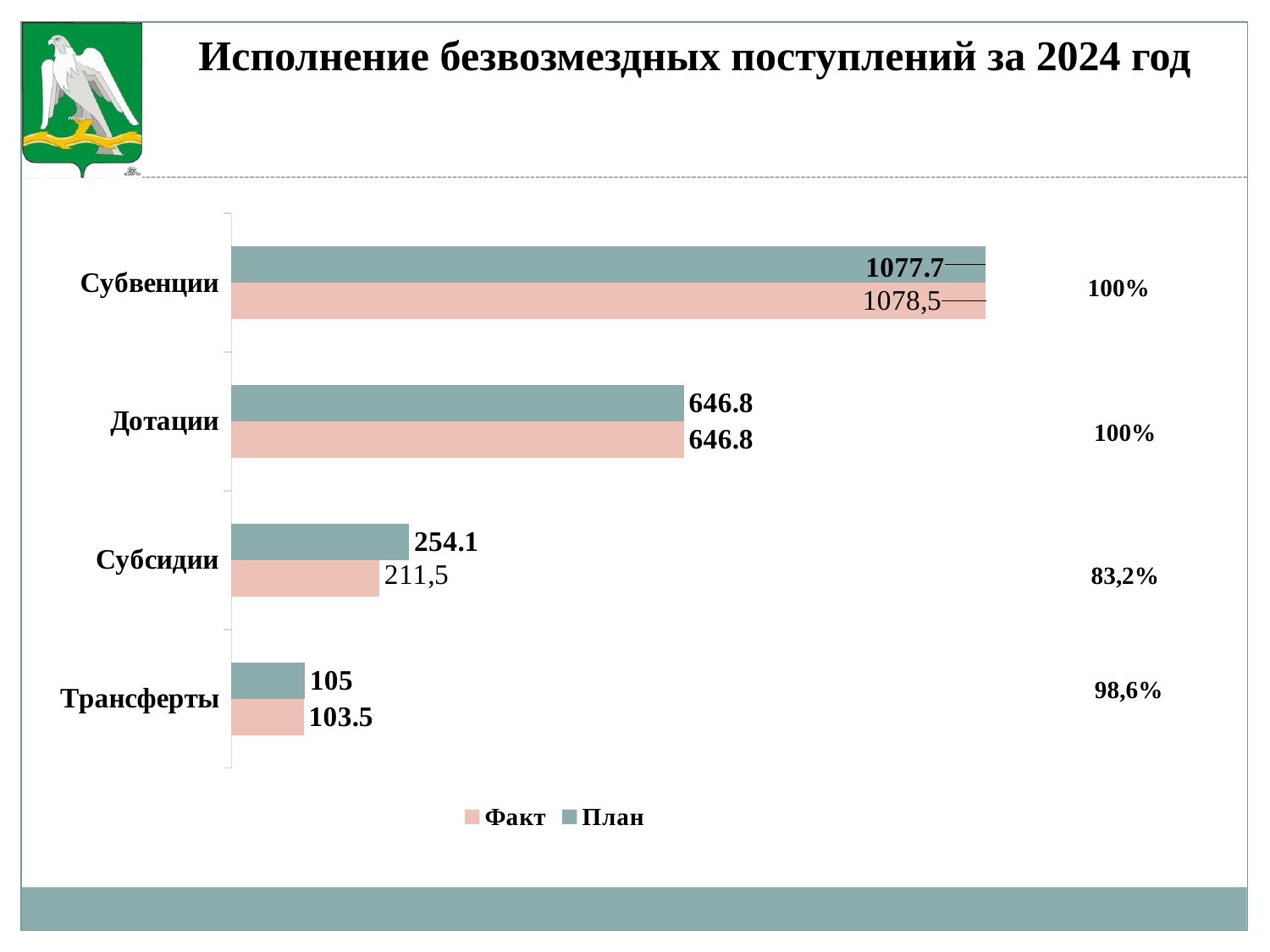
How many series does the legend list? 2 Which category has the highest План value? Субвенции What is the Факт value for Трансферты? 103.5 What is the План value for Субвенции? 1077.7 How many categories are shown in the chart? 4 Which is larger for Субсидии, the План value or the Факт value? План What is the План value for Дотации? 646.8 What kind of chart is shown on the slide? Bar chart What is the difference between the План and Факт values for Субсидии? 42.6 What is the План value for Трансферты? 105 Which category has the lowest Факт value? Трансферты What is the Факт value for Субсидии? 211,5